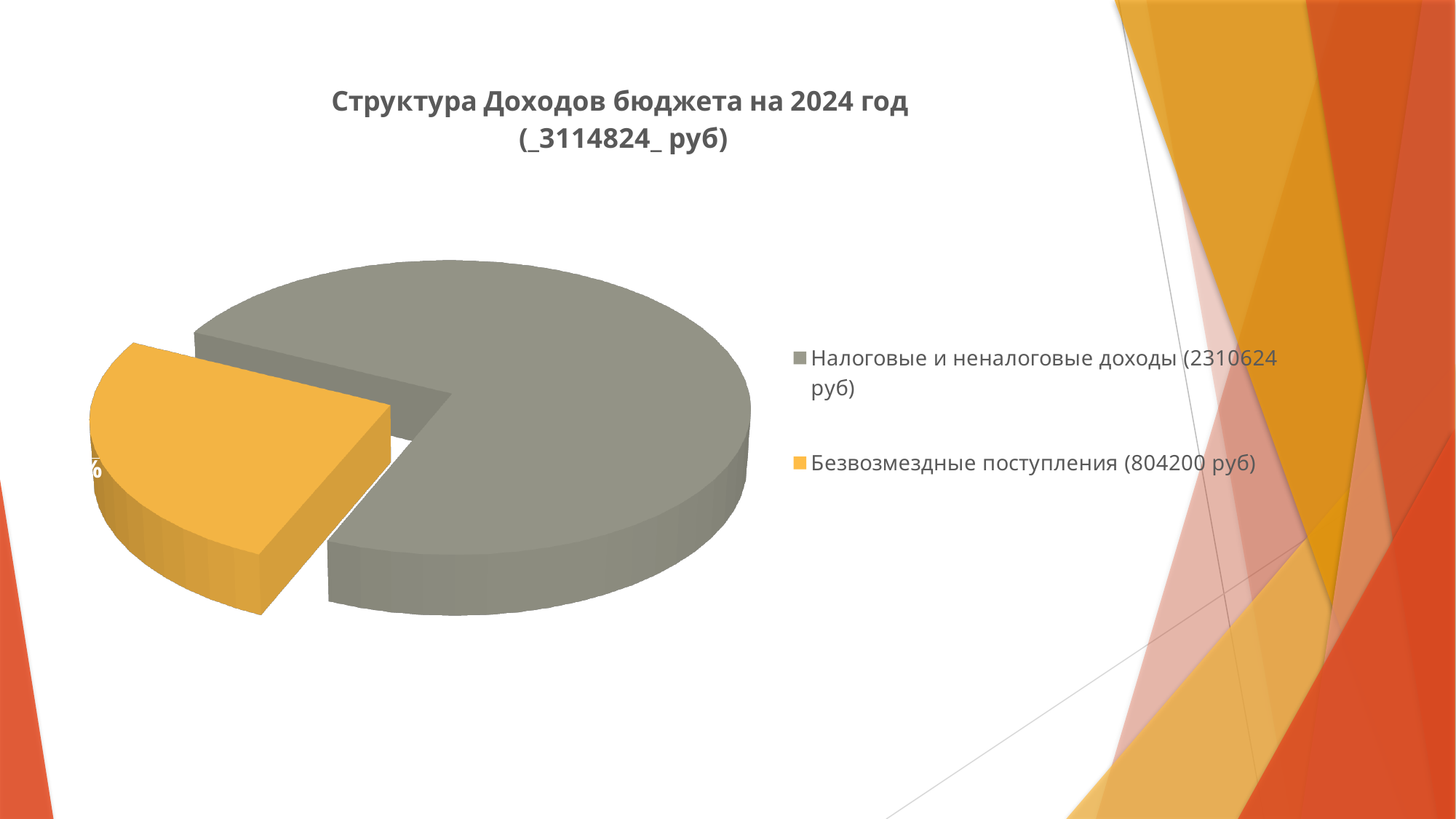
What value is given in the legend for Налоговые и неналоговые доходы? 2310624 руб Which category has the largest slice of the pie? Налоговые и неналоговые доходы Which is larger: Налоговые и неналоговые доходы or Безвозмездные поступления? Налоговые и неналоговые доходы What value is given in the legend for Безвозмездные поступления? 804200 руб What total budget income is stated in the chart title? 3114824 руб How many entries does the legend list? 2 What is the title of the chart? Структура Доходов бюджета на 2024 год (_3114824_ руб) What kind of chart is shown on the slide? pie chart How many slices does the pie chart have? 2 What colour is the slice for Безвозмездные поступления? orange What is the difference between Налоговые и неналоговые доходы (2310624 руб) and Безвозмездные поступления (804200 руб)? 1506424 руб Which category has the smallest slice of the pie? Безвозмездные поступления